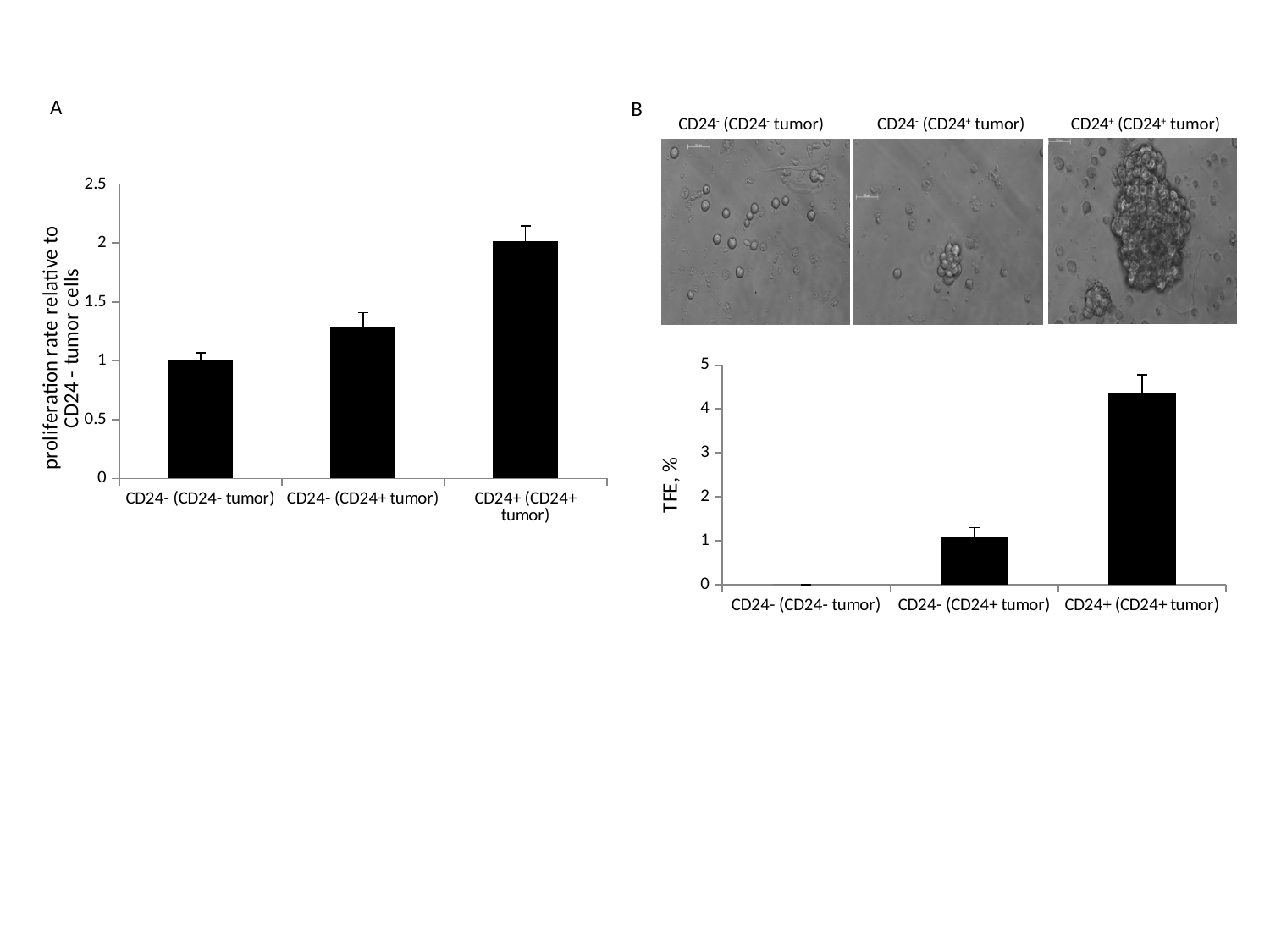
In the panel B bar chart (TFE, %), is the value for CD24+ (CD24+ tumor) greater or less than 4? greater In the panel A chart (proliferation rate), do the bar values rise or fall from left to right along the x axis? rise In the panel A chart (proliferation rate), which category has the highest bar? CD24+ (CD24+ tumor) What kind of chart is the chart in panel A (left side of the slide)? bar chart In the panel A chart (proliferation rate), is the value for CD24- (CD24+ tumor) greater or less than 1.5? less In the panel B bar chart (TFE, %), is the value for CD24- (CD24+ tumor) greater or less than 2? less In the panel B bar chart (TFE, %), which category has the highest bar? CD24+ (CD24+ tumor) In the panel A chart (proliferation rate), which category has the lowest bar? CD24- (CD24- tumor) How many categories are shown on the x axis of the panel A chart (proliferation rate)? 3 What is the y-axis label of the panel B bar chart (lower right of the slide)? TFE, % In the panel B bar chart (TFE, %), which is larger: the value for CD24- (CD24+ tumor) or the value for CD24+ (CD24+ tumor)? CD24+ (CD24+ tumor)